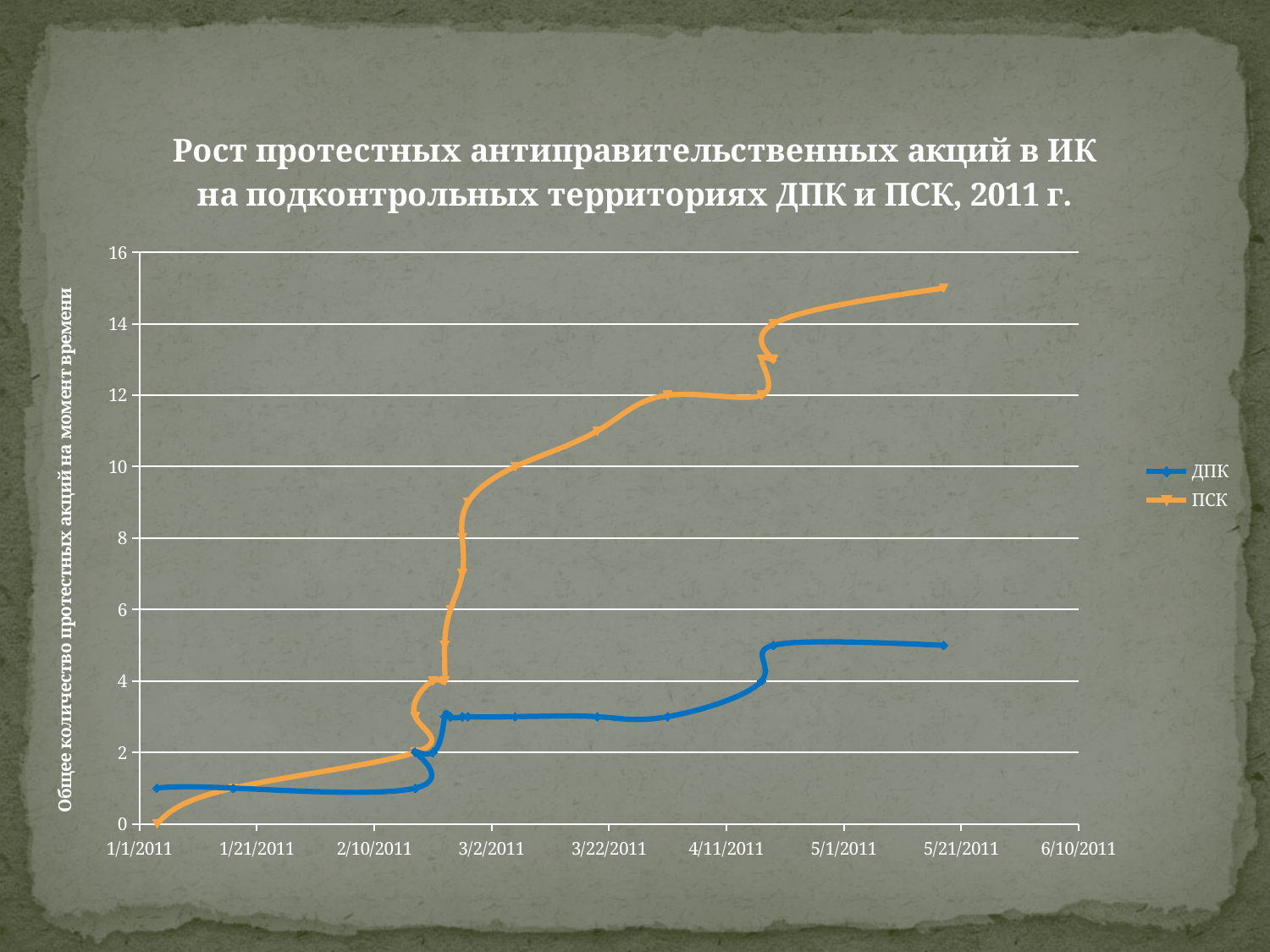
Is the final value for ДПК (around 5/21/2011) greater or less than 4? greater Which series is plotted in orange? ПСК Which series has the higher value at the end of the period, ДПК or ПСК? ПСК What kind of chart is shown on the slide? line chart Which series reaches the highest value on the chart? ПСК Is the value for ПСК on 5/1/2011 greater or less than 12? greater Is the final value for ПСК (around 5/21/2011) greater or less than 14? greater Do the values for ПСК rise or fall over time along the x axis? rise How many series does the legend list? 2 What is the value for ПСК on 1/1/2011? 0